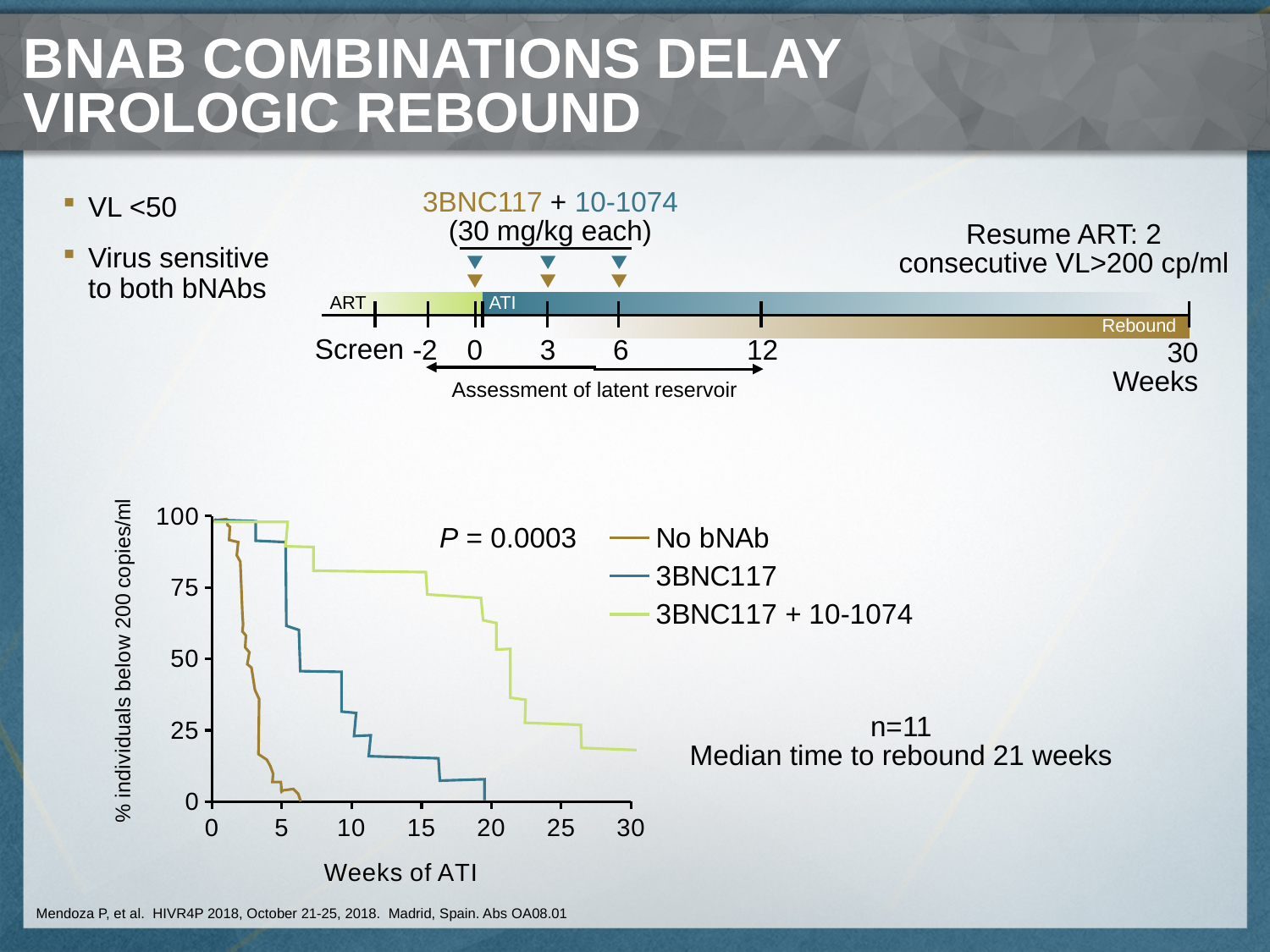
Do the values of the 3BNC117 + 10-1074 curve rise or fall as weeks of ATI increase? fall Is the value for 3BNC117 + 10-1074 at 5 weeks of ATI greater or less than 75? greater What kind of chart is shown at the bottom of the slide? line chart At 10 weeks of ATI, which series has the higher value: 3BNC117 or 3BNC117 + 10-1074? 3BNC117 + 10-1074 Which series reaches 0% individuals below 200 copies/ml first? No bNAb What is the median time to rebound stated next to the chart? 21 weeks Which series has the highest value at 20 weeks of ATI? 3BNC117 + 10-1074 What P value is shown on the chart? P = 0.0003 What is the label of the x axis of the chart? Weeks of ATI How many series does the legend of the chart list? 3 Is the value for 3BNC117 at 15 weeks of ATI greater or less than 25? less Is the value for 3BNC117 + 10-1074 at 30 weeks of ATI greater or less than 25? less